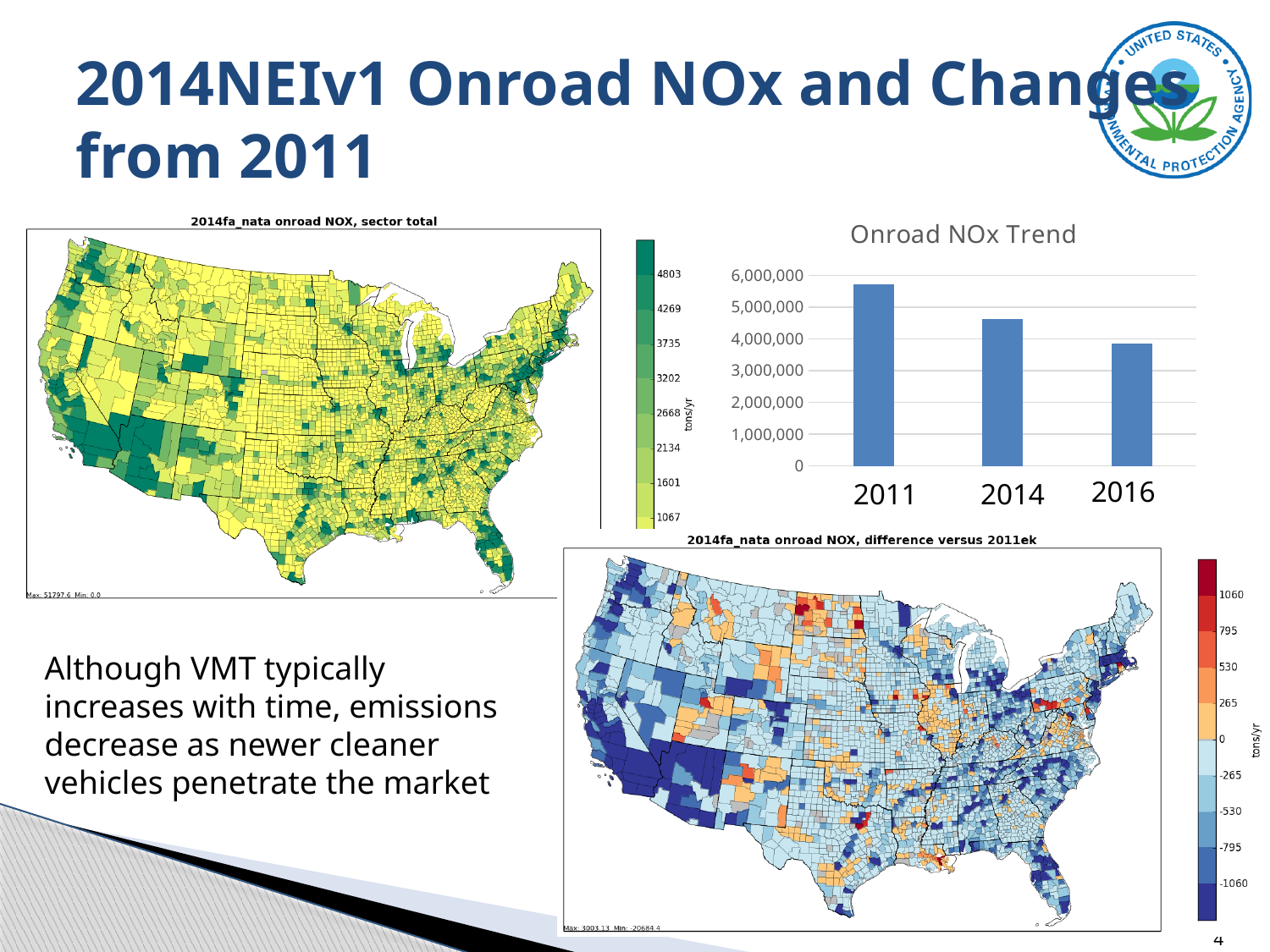
In the Onroad NOx Trend chart, which year has the lowest value? 2016 In the Onroad NOx Trend chart, which is larger, the value for 2014 or the value for 2016? 2014 What is the title of the bar chart on the slide? Onroad NOx Trend What type of chart is the Onroad NOx Trend chart? bar chart In the Onroad NOx Trend chart, is the value for 2014 greater or less than 5,000,000? less In the Onroad NOx Trend chart, is the value for 2014 greater or less than 4,000,000? greater In the Onroad NOx Trend chart, is the value for 2011 greater or less than 5,000,000? greater In the Onroad NOx Trend chart, which year has the highest value? 2011 In the Onroad NOx Trend chart, do the values rise or fall from 2011 to 2016? fall What is the highest tick value shown on the y axis of the Onroad NOx Trend chart? 6,000,000 How many years are shown on the x axis of the Onroad NOx Trend chart? 3